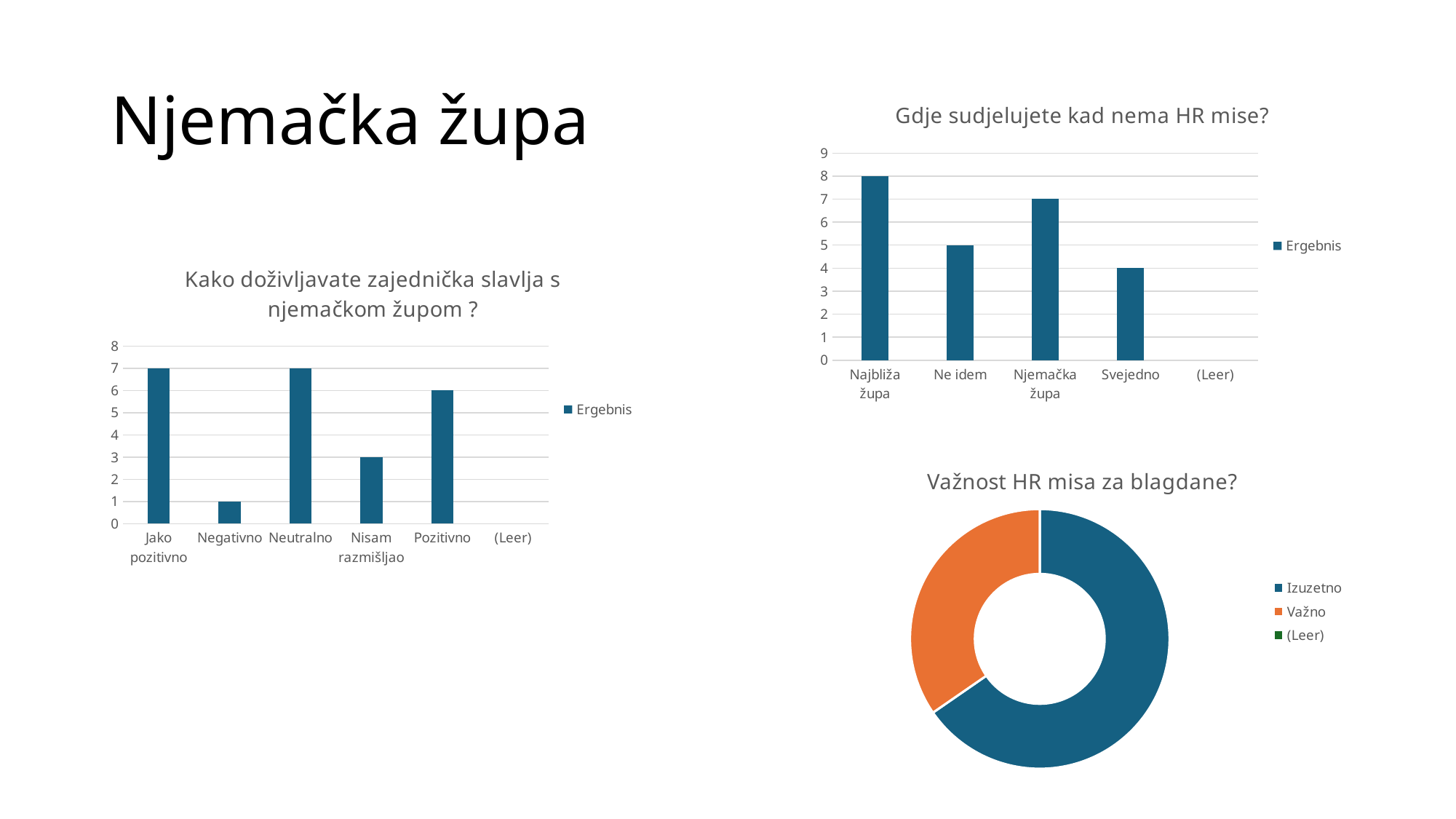
How many categories are shown on the x axis of the chart 'Gdje sudjelujete kad nema HR mise?'? 5 In the chart 'Važnost HR misa za blagdane?', which slice is larger, Izuzetno or Važno? Izuzetno In the chart 'Kako doživljavate zajednička slavlja s njemačkom župom ?', what is the value for Negativno? 1 In the chart 'Kako doživljavate zajednička slavlja s njemačkom župom ?', which is larger, Nisam razmišljao or Pozitivno? Pozitivno In the chart 'Gdje sudjelujete kad nema HR mise?', what is the value for Ne idem? 5 In the chart 'Gdje sudjelujete kad nema HR mise?', which category has the highest value? Najbliža župa In the chart 'Gdje sudjelujete kad nema HR mise?', what is the difference between Njemačka župa and Svejedno? 3 In the chart 'Gdje sudjelujete kad nema HR mise?', what is the value for Najbliža župa? 8 In the chart 'Kako doživljavate zajednička slavlja s njemačkom župom ?', which category has the lowest non-zero value? Negativno In the chart 'Kako doživljavate zajednička slavlja s njemačkom župom ?', what is the value for Pozitivno? 6 What kind of chart is 'Važnost HR misa za blagdane?'? Doughnut chart In the chart 'Kako doživljavate zajednička slavlja s njemačkom župom ?', what is the difference between Jako pozitivno and Nisam razmišljao? 4